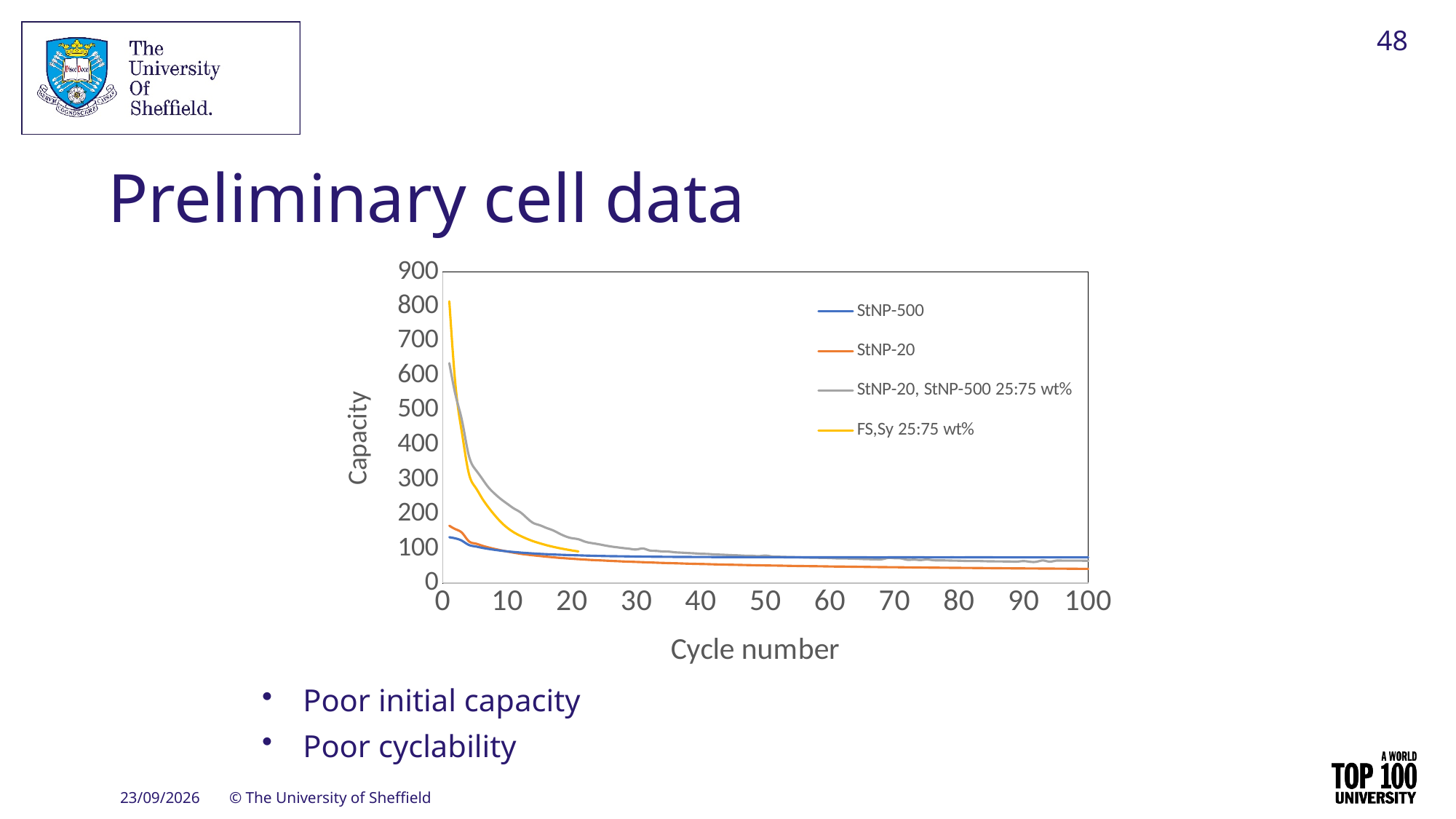
Which series has the highest capacity at the first cycle? FS,Sy 25:75 wt% Is the capacity of StNP-20 at cycle 100 greater or less than 100? less What is the label of the y axis? Capacity Which series has the lowest capacity at cycle 100? StNP-20 Is the capacity of StNP-20, StNP-500 25:75 wt% at cycle 10 greater or less than 200? greater At the first cycle, which series has the larger capacity, FS,Sy 25:75 wt% or StNP-20, StNP-500 25:75 wt%? FS,Sy 25:75 wt% What is the label of the x axis? Cycle number Is the initial capacity of FS,Sy 25:75 wt% greater or less than 700? greater Do the capacity values rise or fall as the cycle number increases? fall How many series does the legend list? 4 What kind of chart is shown on the slide? line chart